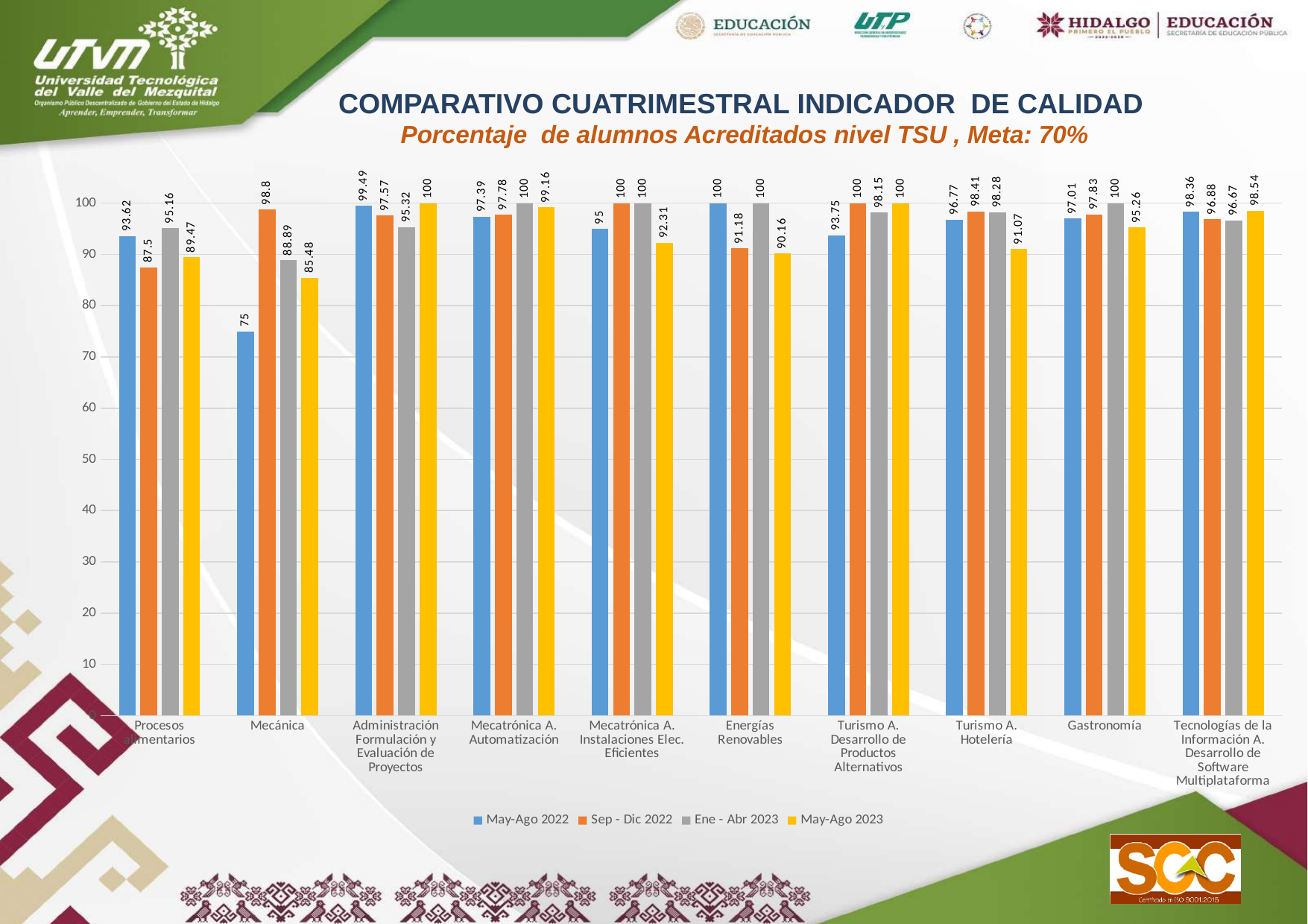
What is the Sep - Dic 2022 value for Procesos alimentarios? 87.5 What is the May-Ago 2023 value for Turismo A. Hotelería? 91.07 What type of chart is shown on the slide? bar chart How many series does the legend list? 4 Which category has the lowest May-Ago 2023 value? Mecánica What is the Ene - Abr 2023 value for Gastronomía? 100 What is the May-Ago 2022 value for Mecánica? 75 Which is larger for Energías Renovables: the Sep - Dic 2022 value or the Ene - Abr 2023 value? Ene - Abr 2023 What target (Meta) is stated in the chart subtitle? 70% Which category has the lowest May-Ago 2022 value? Mecánica What is the difference between the Sep - Dic 2022 and May-Ago 2022 values for Mecánica? 23.8 How many program categories are shown on the x axis? 10